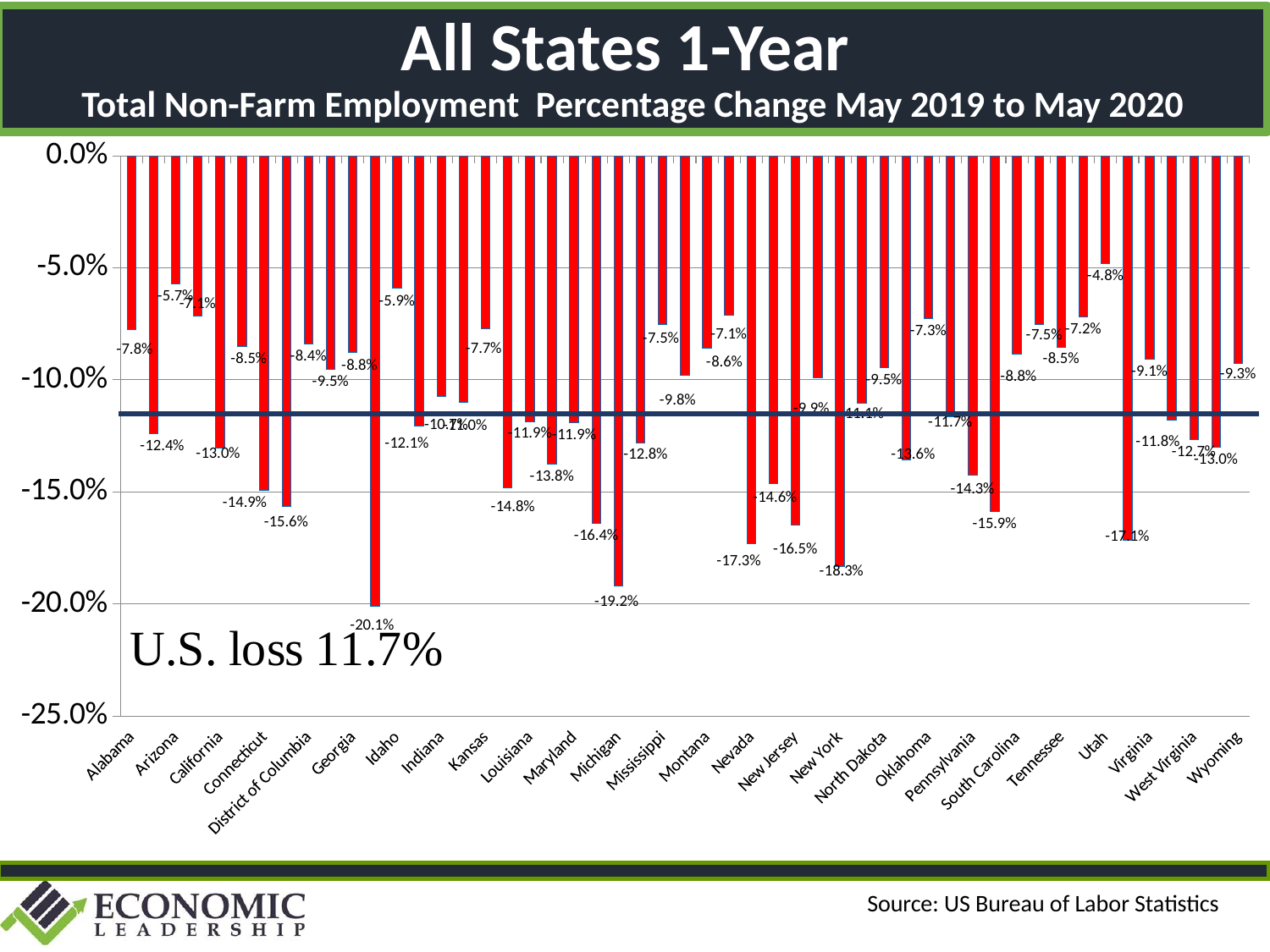
What is the percentage change shown for Wyoming? -9.3% What is the percentage change shown for Nevada? -17.3% Which has the larger employment loss, Nevada or New York? New York What is the difference between the values for Alabama and Wyoming? 1.5% What kind of chart is shown on the slide? bar chart What is the percentage change shown for Alabama? -7.8% Is the value for Arizona greater or less than -10.0%? greater What is the lowest (most negative) value labelled on the chart? -20.1% What is the percentage change shown for Utah? -4.8% What U.S. loss figure is annotated on the chart? 11.7% Which labelled state has the smallest employment loss on the chart? Utah What is the percentage change shown for New York? -18.3%